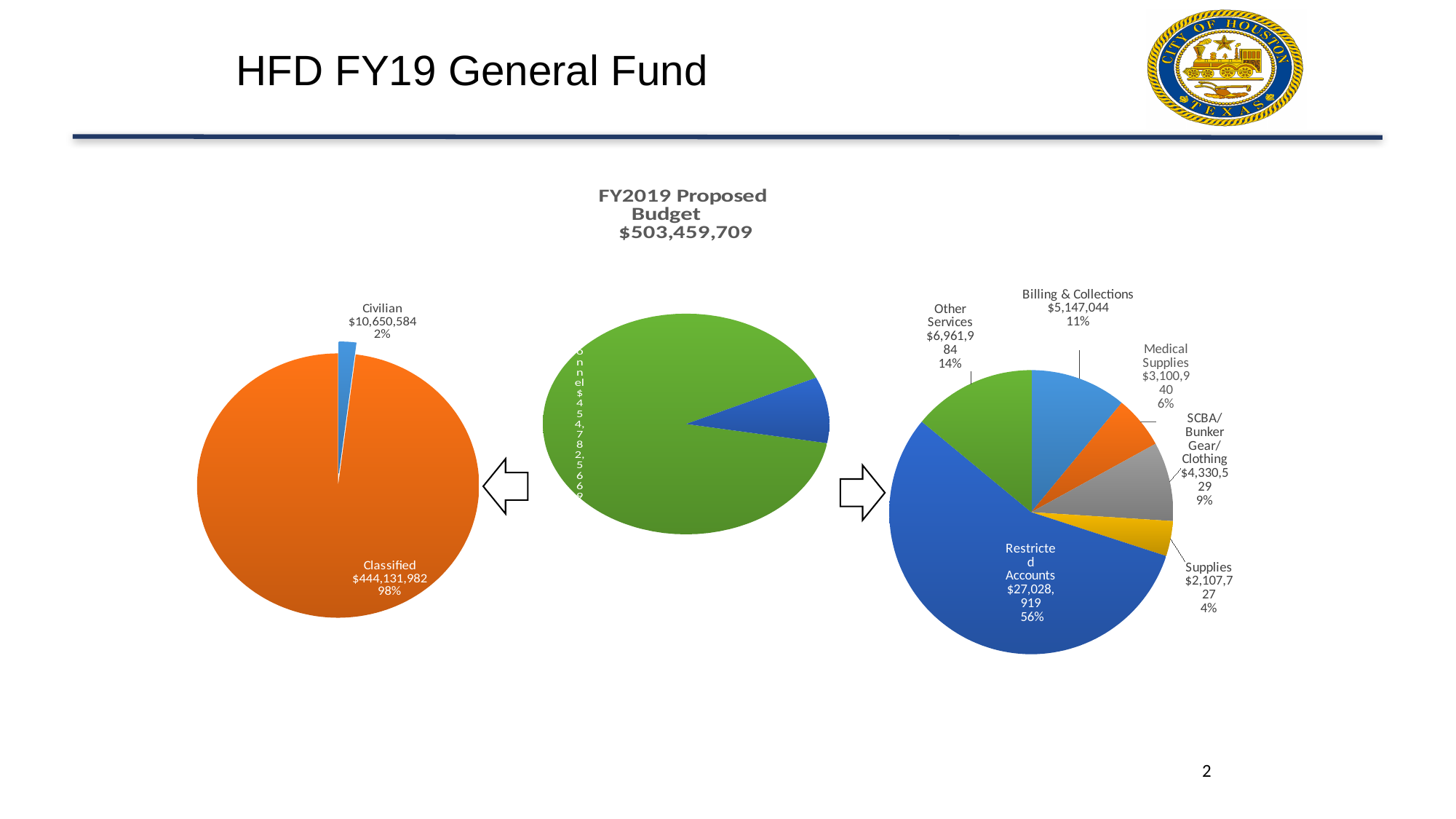
On the right pie chart, which is larger, Billing & Collections or Medical Supplies? Billing & Collections On the right pie chart, which category is the smallest? Supplies On the left pie chart, what share of the pie does Classified represent? 98% On the left pie chart, which category is the largest? Classified On the right pie chart, what is the value for Restricted Accounts? $27,028,919 On the left pie chart, what is the value for Civilian? $10,650,584 On the right pie chart, what share of the pie does Other Services represent? 14% On the right pie chart, how many categories are shown? 6 On the right pie chart, what is the value for SCBA/Bunker Gear/Clothing? $4,330,529 What kind of chart is the middle chart on the slide? Pie chart On the left pie chart, how many categories are shown? 2 What total budget amount is shown in the title of the middle chart? $503,459,709